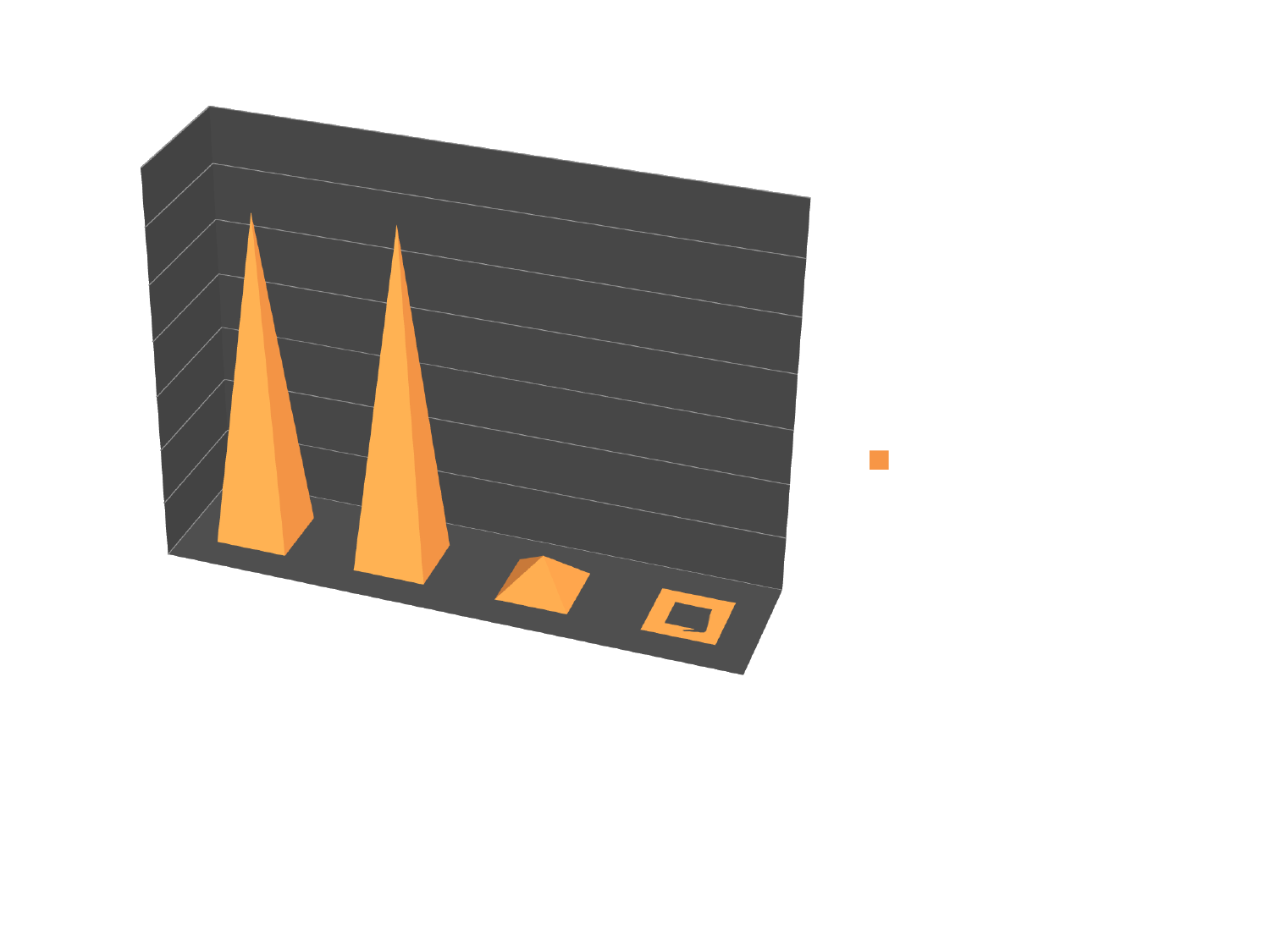
Which is larger, the second bar from the left or the third bar from the left? second Which bar is the lowest: the first, second, third or fourth from the left? fourth How many series does the legend list? 1 How many bars (categories) are plotted in the chart? 4 What colour are the bars in the chart? orange Which is larger, the third bar from the left or the fourth bar from the left? third Which bar is the tallest: the first, second, third or fourth from the left? second What kind of chart is shown on the slide? bar chart What shape are the bars drawn as in this 3D chart? pyramids